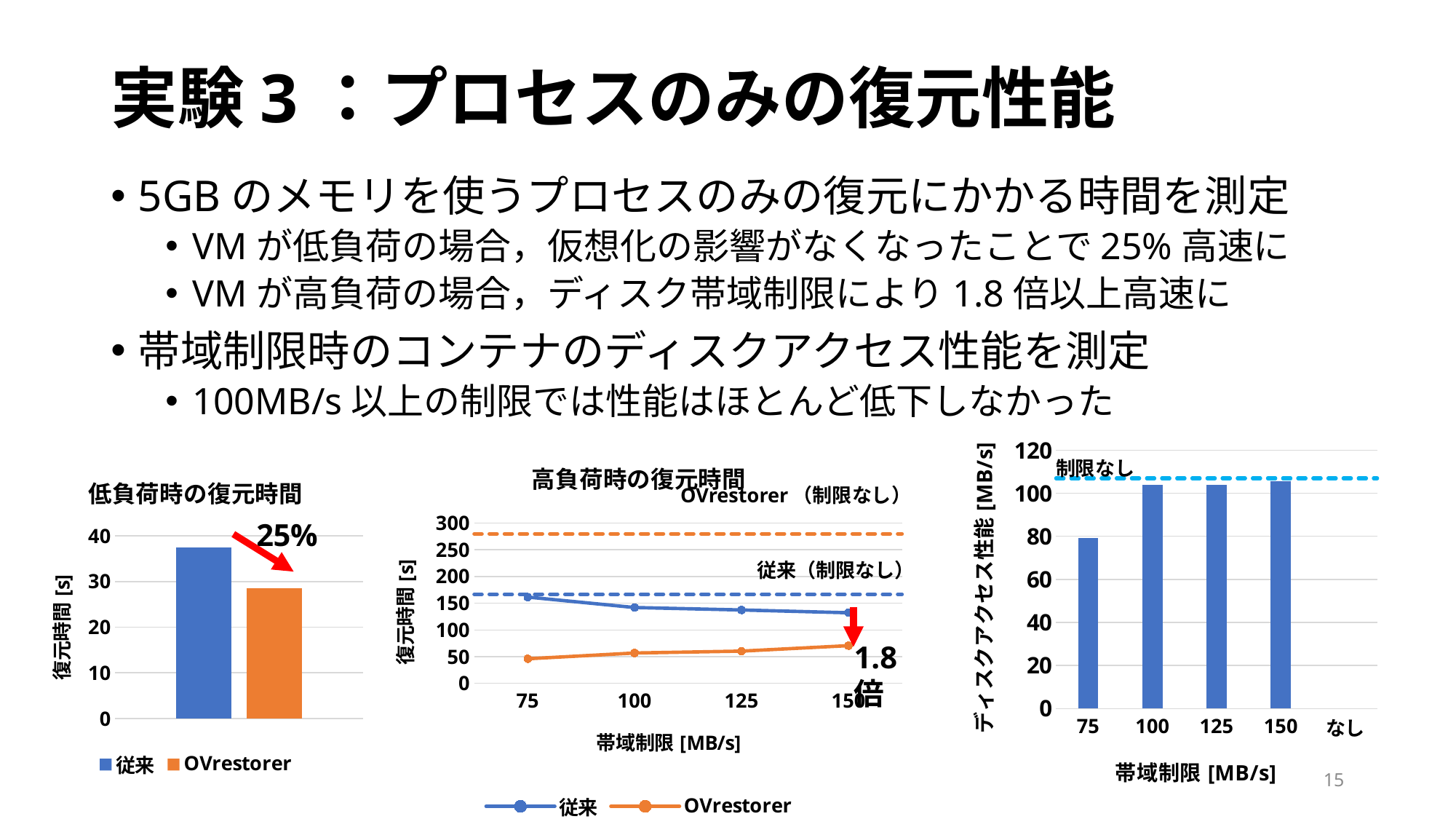
In the chart titled 高負荷時の復元時間, is the 従来 value at 75 MB/s greater or less than 100? greater What kind of chart is the chart titled 低負荷時の復元時間? bar chart What kind of chart is the chart titled 高負荷時の復元時間? line chart In the chart titled 高負荷時の復元時間, does the 従来 line rise or fall as 帯域制限 increases from 75 to 150? fall In the chart titled 低負荷時の復元時間, is the value for OVrestorer greater or less than 30? less In the chart titled 低負荷時の復元時間, which series has the larger value, 従来 or OVrestorer? 従来 In the chart titled 低負荷時の復元時間, is the value for 従来 greater or less than 30? greater How many points along the x axis does the chart titled 高負荷時の復元時間 have? 4 How many series does the legend of the chart titled 低負荷時の復元時間 list? 2 In the rightmost chart (ディスクアクセス性能), which 帯域制限 category has the lowest bar? 75 In the chart titled 高負荷時の復元時間, which series has the lower value at 150 MB/s, 従来 or OVrestorer? OVrestorer